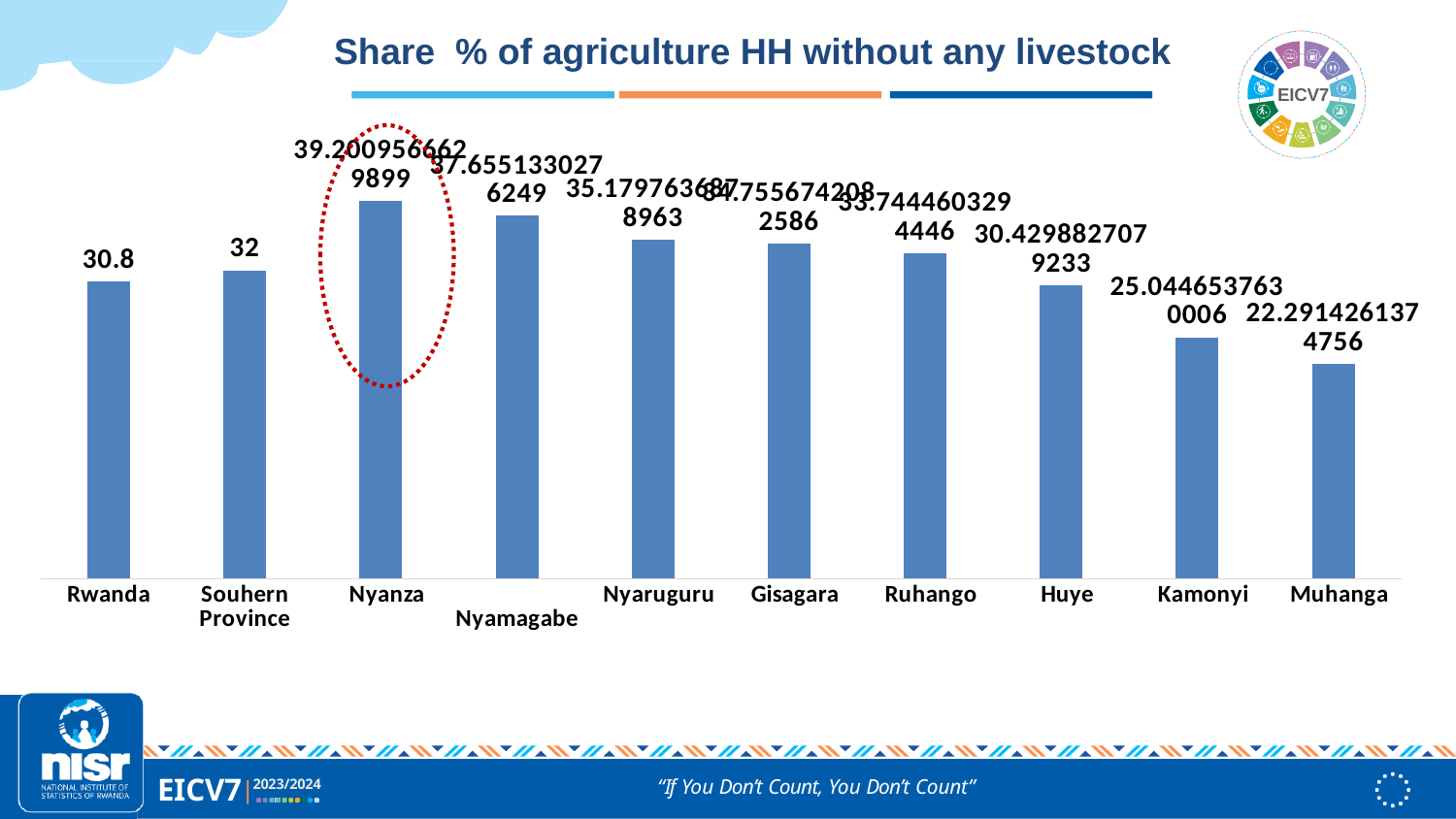
Which has a larger value, Kamonyi or Muhanga? Kamonyi What is the value shown for Muhanga? 22.2914261374756 Which category has the highest value? Nyanza What is the value shown for Kamonyi? 25.0446537630006 How many categories are shown on the x axis? 10 Which category has the lowest value? Muhanga What kind of chart is shown on the slide? Bar chart What is the value shown for Huye? 30.4298827079233 What is the value for Rwanda? 30.8 What is the difference between the values for Souhern Province and Rwanda? 1.2 What is the value for Souhern Province? 32 Which bar is highlighted with a red dotted circle? Nyanza